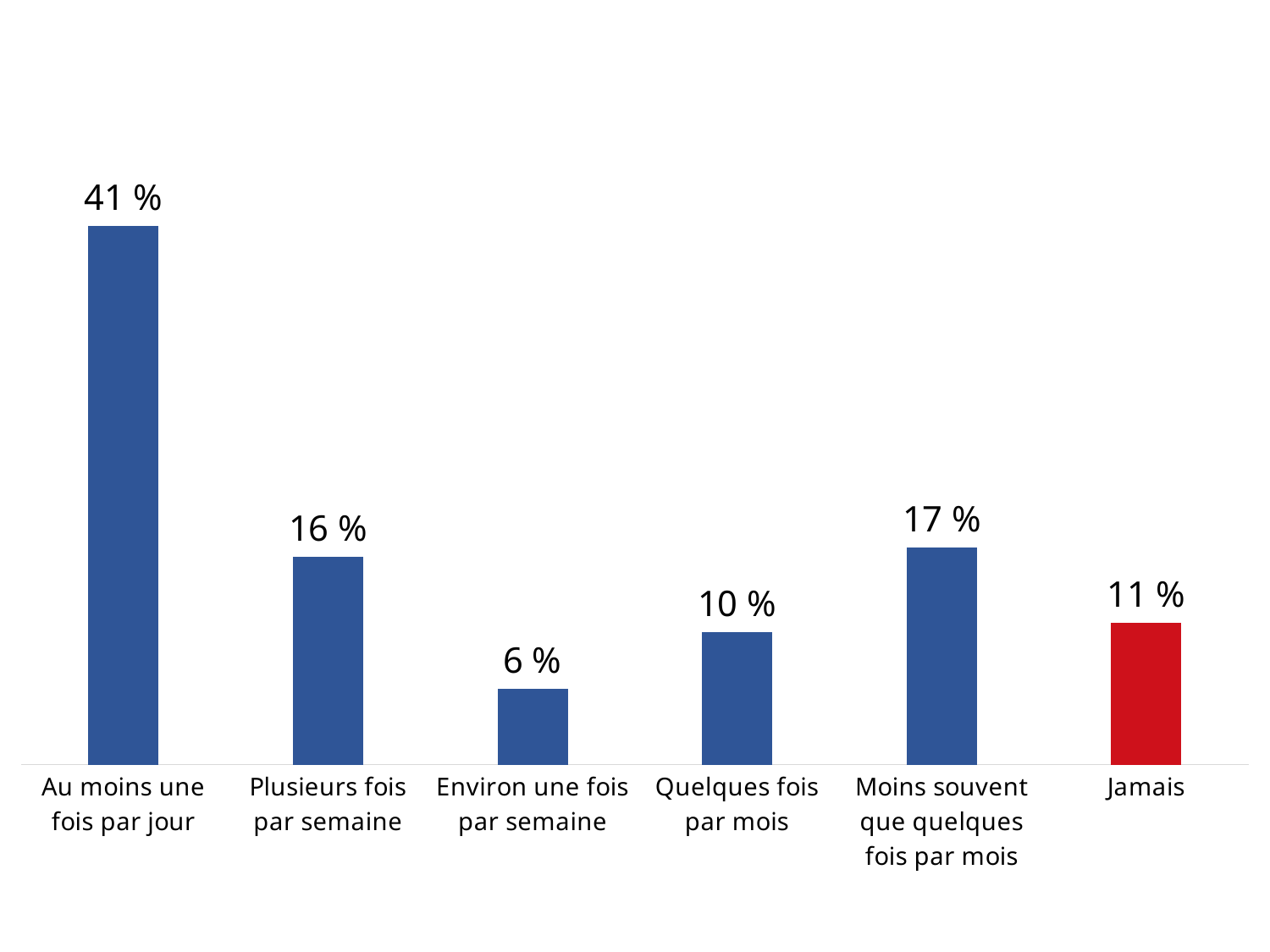
What is the value for "Jamais"? 11 % What is the value for "Au moins une fois par jour"? 41 % What kind of chart is this? Bar chart Which bar is coloured red rather than blue? Jamais Which category has the lowest value? Environ une fois par semaine What is the difference between the values for "Moins souvent que quelques fois par mois" and "Quelques fois par mois"? 7 % What is the difference between the values for "Au moins une fois par jour" and "Plusieurs fois par semaine"? 25 % Which is larger, the value for "Plusieurs fois par semaine" or the value for "Jamais"? Plusieurs fois par semaine Which category has the highest value? Au moins une fois par jour What is the value for "Moins souvent que quelques fois par mois"? 17 % What is the value for "Environ une fois par semaine"? 6 % How many categories are shown on the chart? 6